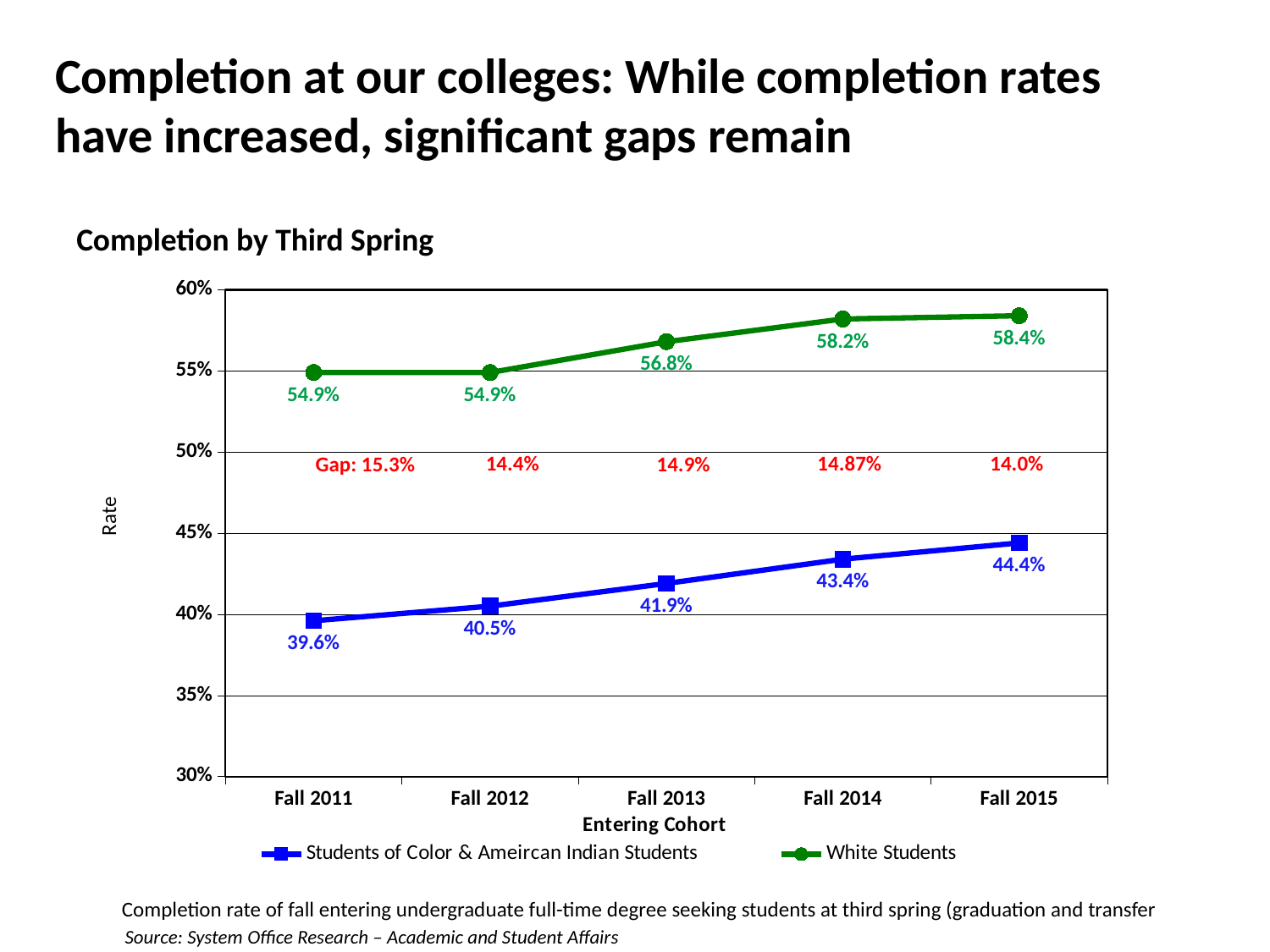
Is the completion rate for Students of Color & American Indian Students in Fall 2014 greater or less than 45%? less Which entering cohort has the highest completion rate for White Students? Fall 2015 What is the completion rate for White Students in the Fall 2013 cohort? 56.8% What kind of chart is shown on the slide? line chart What is the difference between the White Students rate and the Students of Color & American Indian Students rate for the Fall 2015 cohort? 14.0% Which entering cohort has the lowest completion rate for Students of Color & American Indian Students? Fall 2011 What is the completion rate for Students of Color & American Indian Students in the Fall 2011 cohort? 39.6% Which series has the higher completion rate in the Fall 2014 cohort? White Students Does the completion rate for Students of Color & American Indian Students rise or fall from Fall 2011 to Fall 2015? rise How many entering cohorts are shown on the x axis? 5 How many series does the legend list? 2 What is the completion rate for Students of Color & American Indian Students in the Fall 2015 cohort? 44.4%